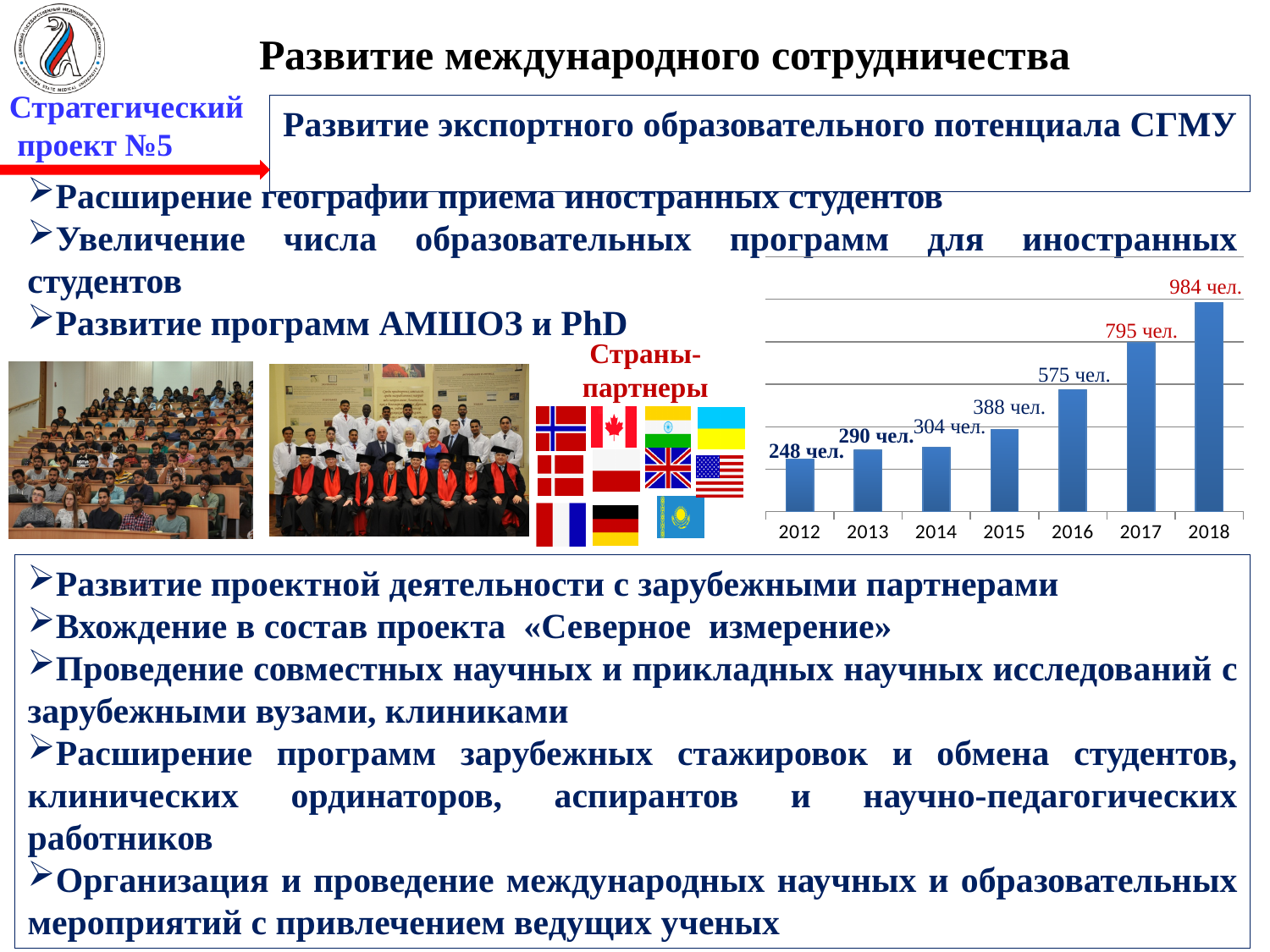
What is the value for 2018 in the chart? 984 чел. What is the value for 2012 in the chart? 248 чел. How many years are shown on the x axis of the chart? 7 Which is larger in the chart, the value for 2014 or the value for 2013? 2014 What is the difference between the values for 2018 and 2017 in the chart? 189 чел. What is the value for 2016 in the chart? 575 чел. Do the values in the chart rise or fall from 2012 to 2018? rise What is the value for 2015 in the chart? 388 чел. Which year has the lowest value in the chart? 2012 What is the difference between the values for 2016 and 2015 in the chart? 187 чел. Which year has the highest value in the chart? 2018 What type of chart is shown on the slide? bar chart